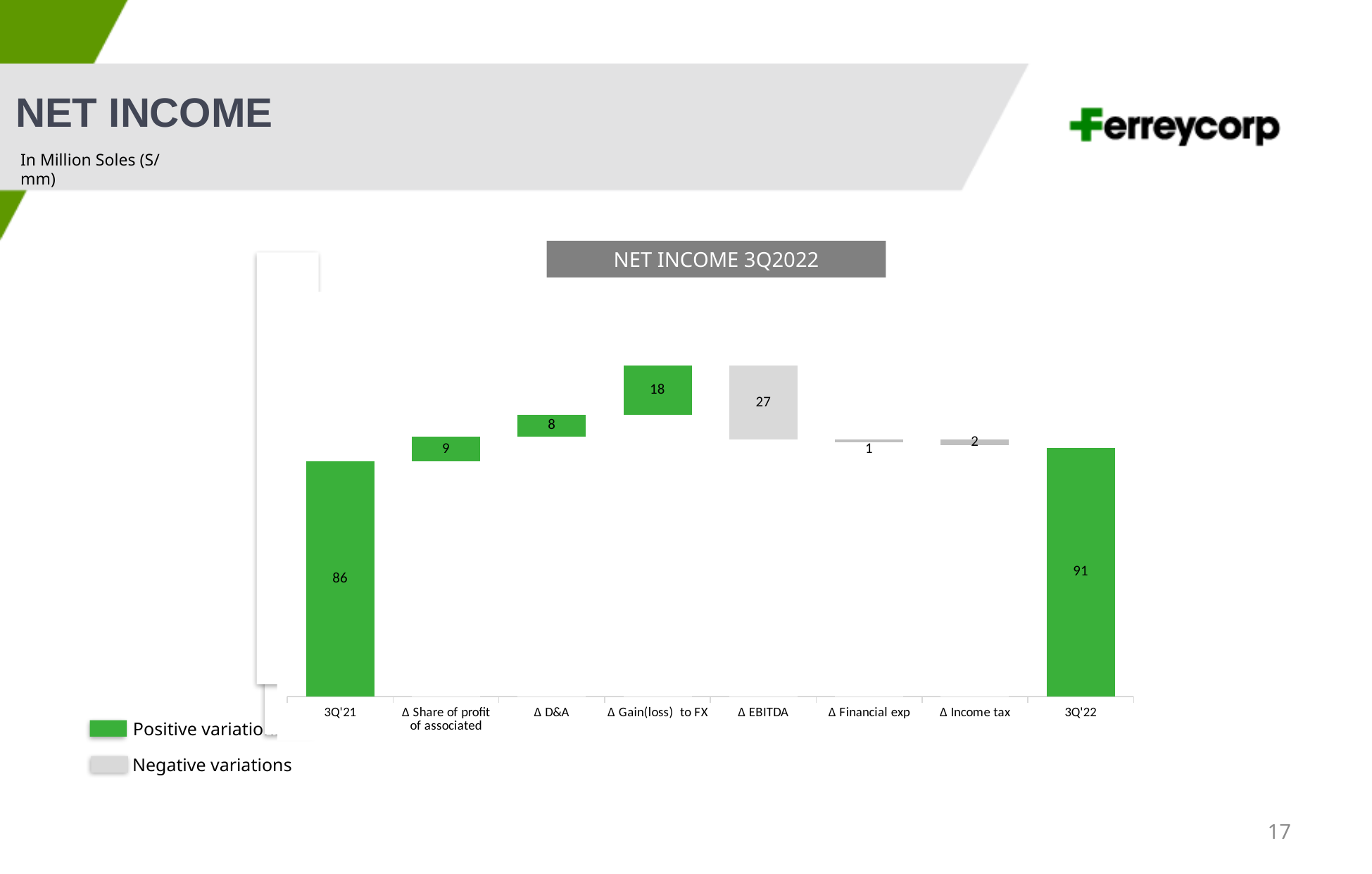
What is the value of the Δ D&A bar? 8 What is the value of the Δ Share of profit of associated bar? 9 What do the grey bars represent according to the legend? Negative variations Which category has the largest value in the chart? 3Q'22 What is the value of the Δ Gain(loss) to FX bar? 18 What is the difference between the 3Q'22 and 3Q'21 net income values? 5 What is the value of the Δ EBITDA bar? 27 What is the net income value shown for 3Q'22? 91 What is the net income value shown for 3Q'21? 86 How many categories are shown on the x axis of the chart? 8 Which category has the smallest value in the chart? Δ Financial exp Which is larger, the Δ Gain(loss) to FX bar or the Δ D&A bar? Δ Gain(loss) to FX